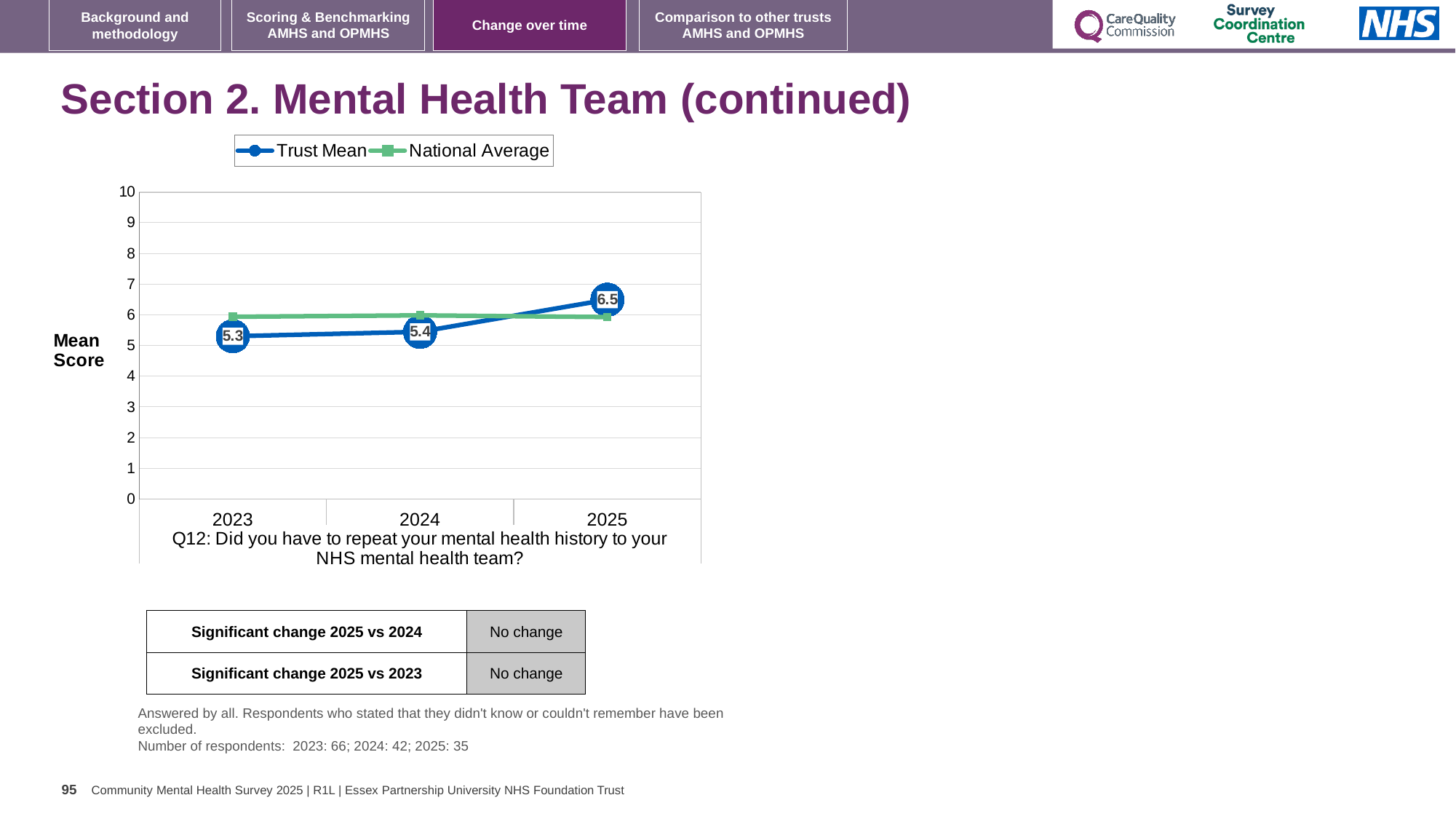
What is the difference between the Trust Mean in 2025 and in 2023? 1.2 How many years are shown on the x axis of the chart? 3 Does the Trust Mean rise or fall from 2023 to 2025? rise What is the Trust Mean value for 2023? 5.3 How many series does the chart legend list? 2 What is the Trust Mean value for 2025? 6.5 Is the National Average value for 2024 greater or less than 5? greater In which year is the Trust Mean highest? 2025 In which year is the Trust Mean lowest? 2023 In 2023, which is larger: the Trust Mean or the National Average? National Average What is the Trust Mean value for 2024? 5.4 In 2025, which is larger: the Trust Mean or the National Average? Trust Mean